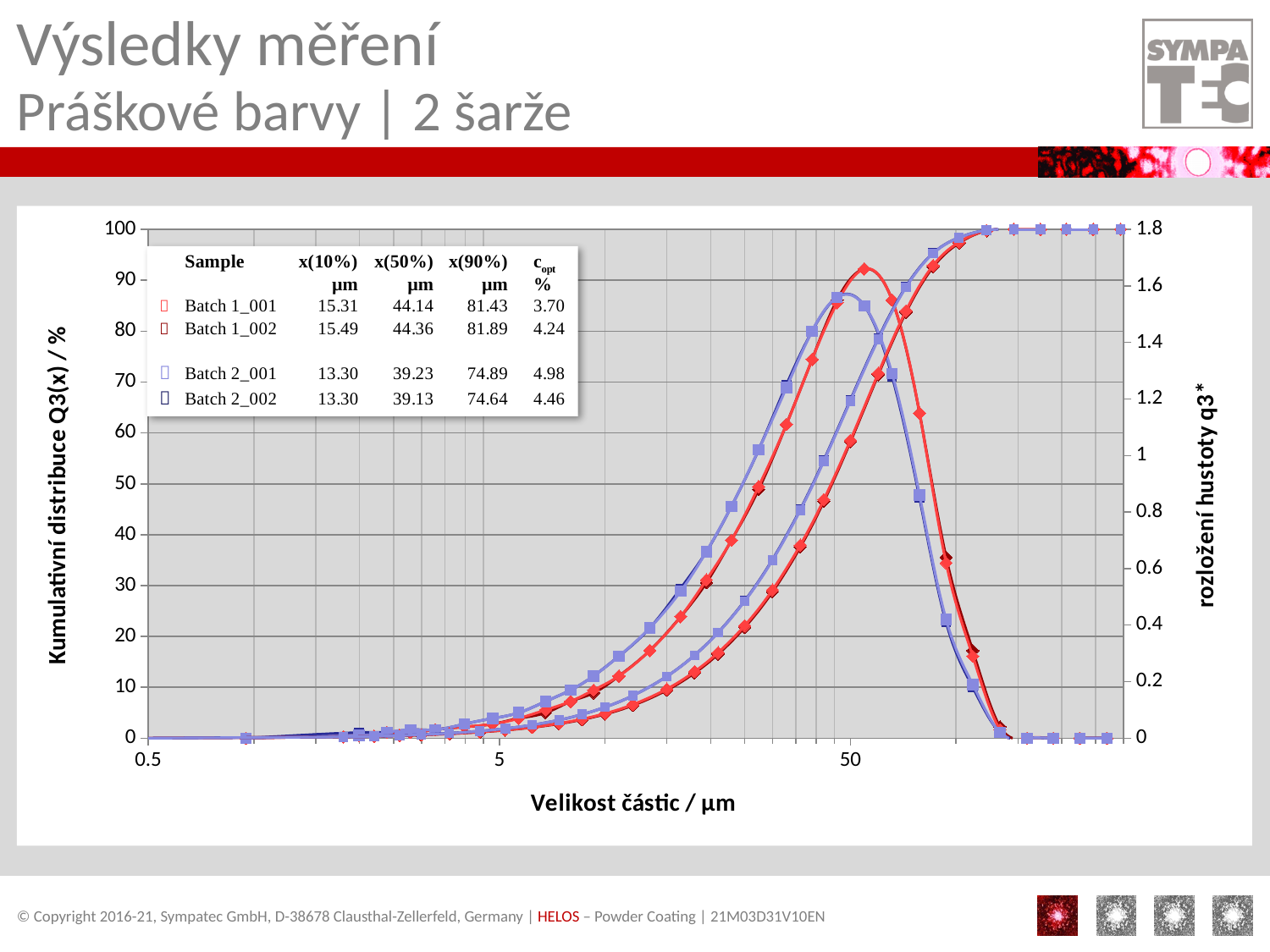
What is the difference between the x(90%) values of Batch 1_001 and Batch 2_001? 6.54 According to the table in the chart, what is the x(50%) value for Batch 1_001? 44.14 Which sample in the table has the highest x(90%) value? Batch 1_002 Which sample in the table has the highest c_opt value? Batch 2_001 Which has the larger x(50%) value, Batch 1_001 or Batch 2_001? Batch 1_001 Do the cumulative distribution curves rise or fall as particle size increases along the x axis? rise According to the table in the chart, what is the c_opt value for Batch 2_001? 4.98 What kind of chart is shown on the slide? line chart According to the table in the chart, what is the x(90%) value for Batch 2_002? 74.64 How many samples are listed in the table on the chart? 4 What is the label of the x axis of the chart? Velikost částic / µm What is the difference between the x(50%) values of Batch 1_002 and Batch 1_001? 0.22